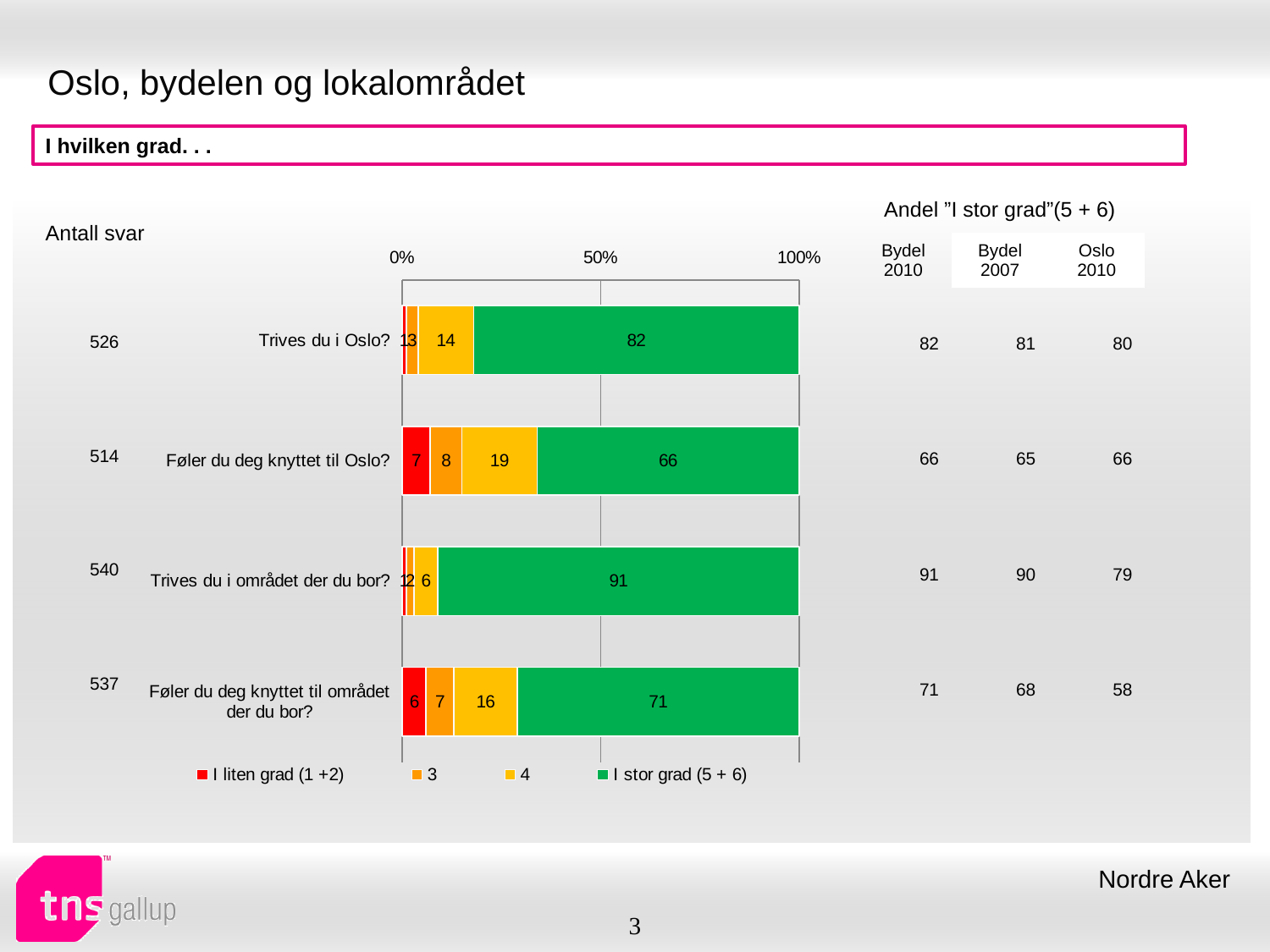
What kind of chart is shown on the slide? stacked bar chart What is the value of "I stor grad (5 + 6)" for "Føler du deg knyttet til Oslo?"? 66 Which category has the highest value for "I stor grad (5 + 6)"? Trives du i området der du bor? What is the difference between the "I stor grad (5 + 6)" values for "Trives du i området der du bor?" and "Føler du deg knyttet til området der du bor?"? 20 What is the value of "4" for "Føler du deg knyttet til området der du bor?"? 16 Which category has the lowest value for "I stor grad (5 + 6)"? Føler du deg knyttet til Oslo? What is the "Antall svar" shown for "Trives du i området der du bor?"? 540 What is the value of "I stor grad (5 + 6)" for "Trives du i Oslo?"? 82 Which is larger: the "4" value for "Føler du deg knyttet til Oslo?" or for "Trives du i Oslo?"? Føler du deg knyttet til Oslo? How many series does the chart legend list? 4 How many question categories are plotted in the chart? 4 What is the value of "I liten grad (1 +2)" for "Føler du deg knyttet til Oslo?"? 7